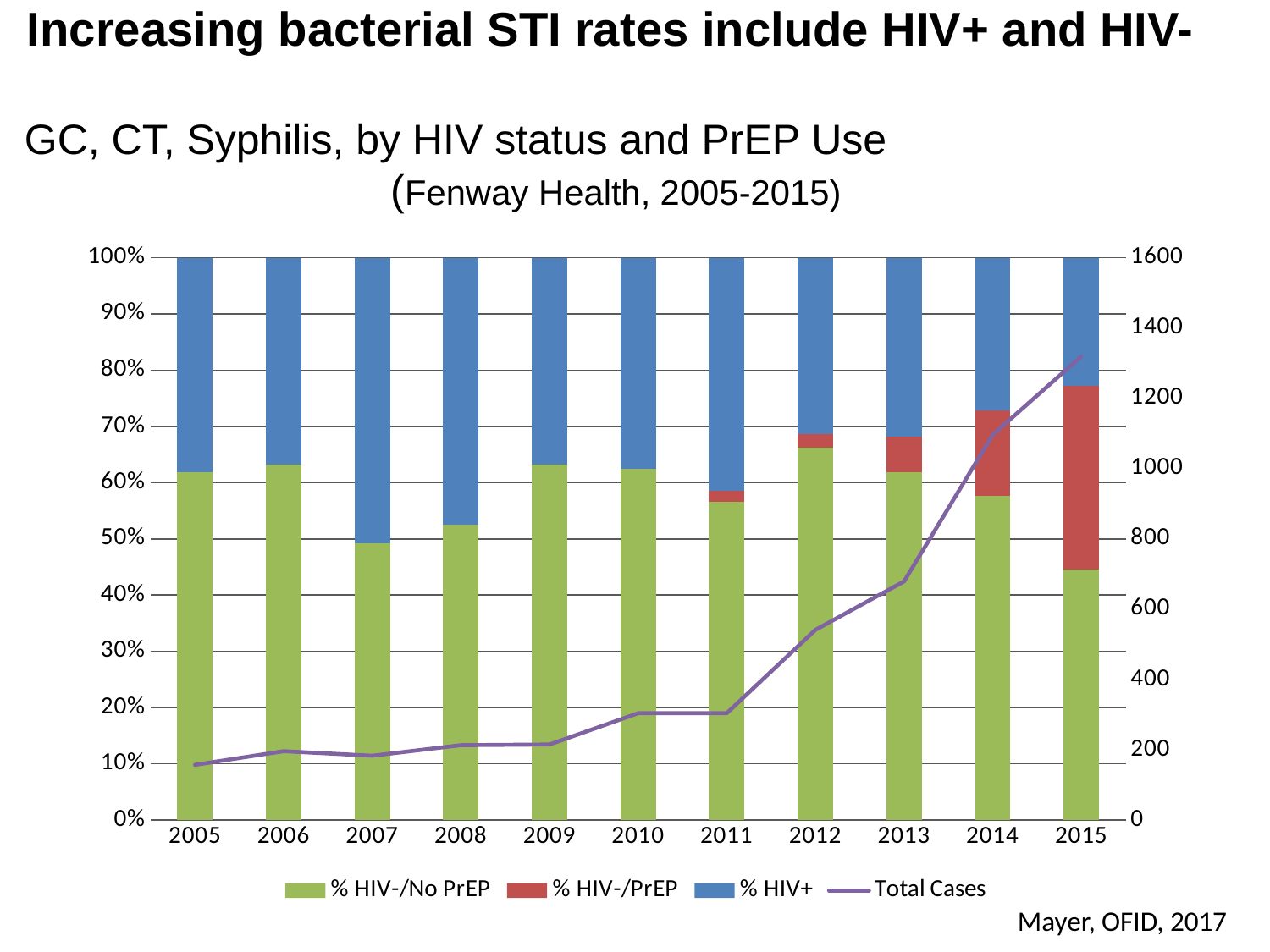
Is the Total Cases value for 2015 greater or less than 1200? greater Which is larger, the Total Cases value for 2014 or for 2012? 2014 Which year has the lowest Total Cases? 2005 Does the Total Cases line rise or fall from 2005 to 2015? Rises Which year has the largest % HIV-/PrEP share? 2015 Which year has the highest Total Cases? 2015 How many years are shown on the x axis of the chart? 11 How many series does the chart's legend list? 4 Is the % HIV-/No PrEP share for 2015 greater or less than 50%? less What kind of chart is shown on the slide? Stacked bar chart with a line Is the Total Cases value for 2005 greater or less than 200? less Which series is plotted as a line rather than as bars? Total Cases